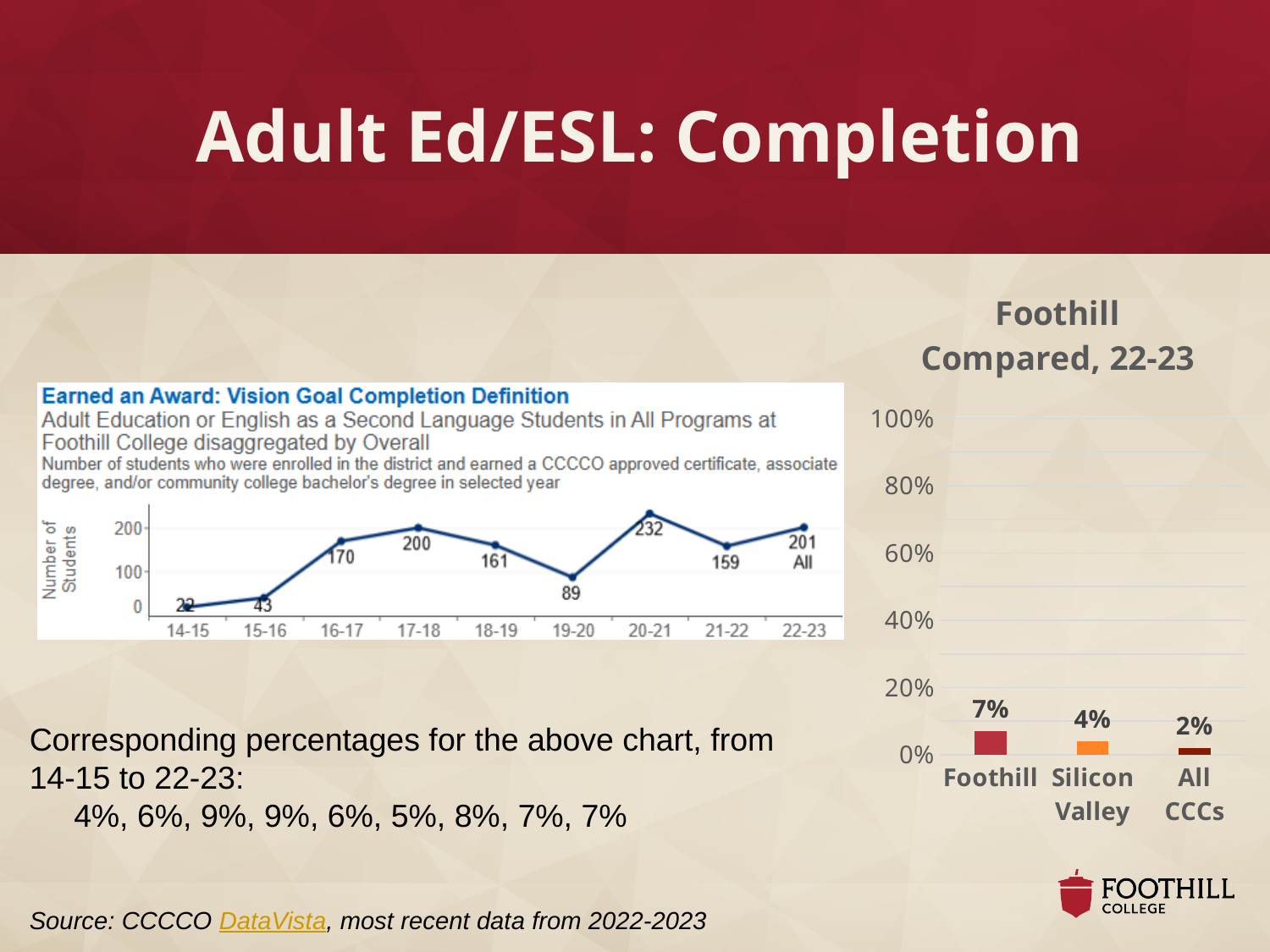
In the 'Earned an Award' line chart, what is the value for 22-23? 201 In the 'Earned an Award' line chart, is the value for 17-18 or 18-19 larger? 17-18 In the 'Earned an Award' line chart, what is the value for 19-20? 89 In the 'Foothill Compared, 22-23' chart, which category has the highest value? Foothill In the 'Earned an Award' line chart, how many years are plotted on the x axis? 9 What kind of chart is the 'Earned an Award' chart on the left? Line chart In the 'Earned an Award' line chart, which year has the highest number of students? 20-21 In the 'Earned an Award' line chart, which year has the lowest number of students? 14-15 In the 'Foothill Compared, 22-23' chart, what is the difference between Foothill and All CCCs? 5% In the 'Earned an Award' line chart, how many students earned an award in 20-21? 232 In the 'Earned an Award' line chart, what is the difference between the values for 20-21 and 21-22? 73 In the 'Foothill Compared, 22-23' chart, what is the value for Silicon Valley? 4%